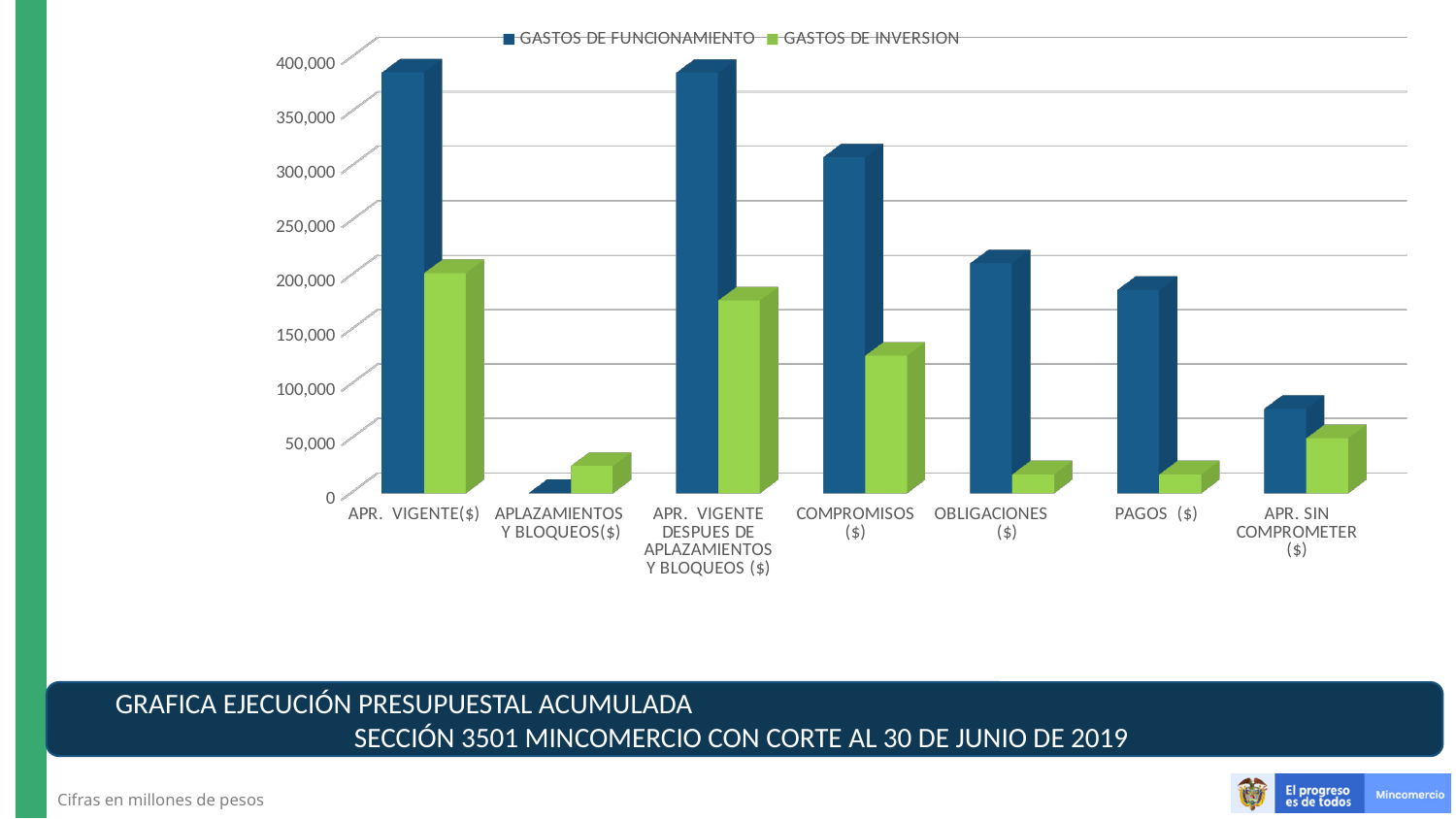
For COMPROMISOS ($), which series has the larger value, GASTOS DE FUNCIONAMIENTO or GASTOS DE INVERSION? GASTOS DE FUNCIONAMIENTO Is the GASTOS DE FUNCIONAMIENTO value for APR. VIGENTE($) greater or less than 350,000? greater Which category has the highest value for GASTOS DE INVERSION? APR. VIGENTE($) Is the GASTOS DE INVERSION value for APR. VIGENTE($) greater or less than 150,000? greater For APLAZAMIENTOS Y BLOQUEOS($), which series has the larger value, GASTOS DE FUNCIONAMIENTO or GASTOS DE INVERSION? GASTOS DE INVERSION What kind of chart is shown on the slide? Bar chart How many categories are shown on the x axis? 7 Is the GASTOS DE FUNCIONAMIENTO value for APR. SIN COMPROMETER ($) greater or less than 100,000? less Which category has the lowest value for GASTOS DE FUNCIONAMIENTO? APLAZAMIENTOS Y BLOQUEOS($) Which colour represents GASTOS DE INVERSION in the chart? Green How many series does the legend list? 2